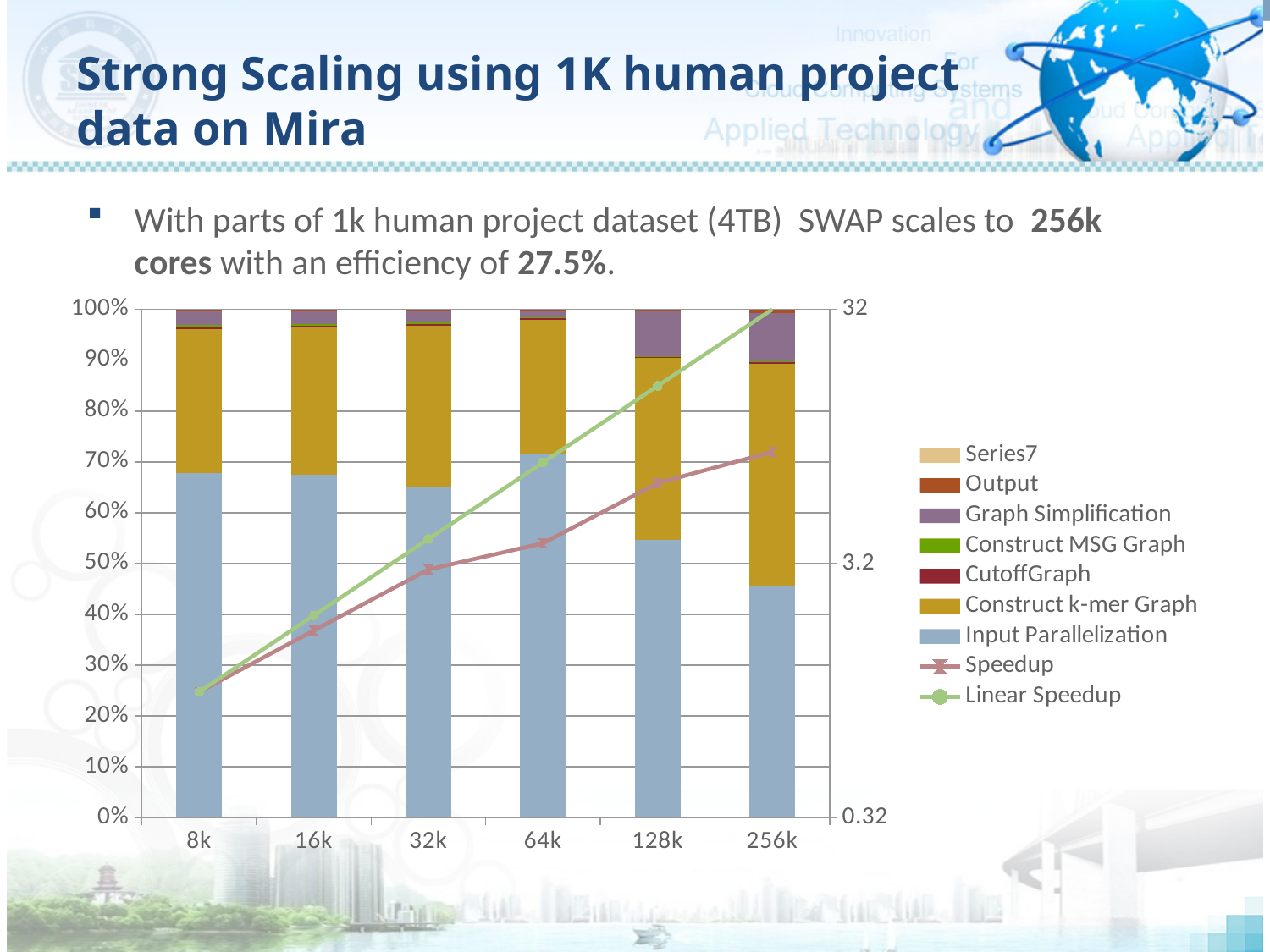
Which legend entry is shown with a green line and circle markers? Linear Speedup Is the Input Parallelization share at 8k greater or less than 60%? greater At 256k cores, which line is higher, Speedup or Linear Speedup? Linear Speedup How many series does the chart legend list? 9 Which has a larger Input Parallelization share, 128k or 256k? 128k How many core-count categories are shown on the x axis of the chart? 6 Is the Speedup value at 8k greater or less than 3.2 on the right-hand axis? less Does the Linear Speedup line rise or fall as the core count increases from 8k to 256k? rises Is the Speedup value at 256k greater or less than 3.2 on the right-hand axis? greater Which core count has the smallest Input Parallelization share of the bar? 256k What kind of chart is used to show the time breakdown across core counts? Stacked bar chart (with line series overlaid)